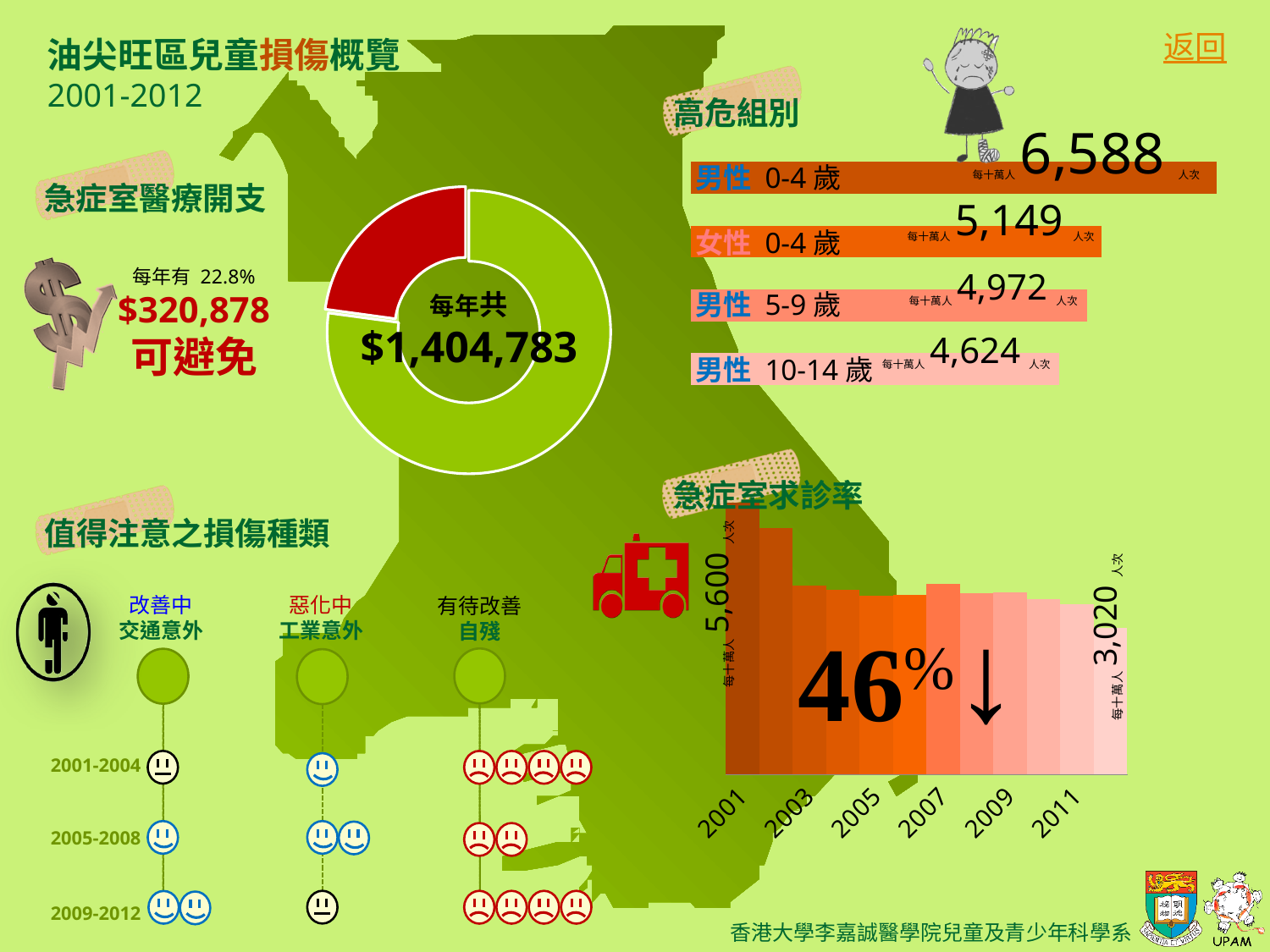
What kind of chart is used for 急症室醫療開支? Donut (pie) chart In the 急症室醫療開支 donut chart, what is the total annual amount (每年共)? $1,404,783 In the 高危組別 bar chart, what is the value for 女性 0-4 歲? 5,149 In the 高危組別 bar chart, what is the difference between 男性 0-4 歲 and 女性 0-4 歲? 1,439 In the 高危組別 bar chart, which group has the lowest value? 男性 10-14 歲 In the 高危組別 bar chart, which group has the highest value? 男性 0-4 歲 In the 高危組別 bar chart, which is larger: 男性 5-9 歲 or 男性 10-14 歲? 男性 5-9 歲 In the 急症室求診率 bar chart, do the values rise or fall from 2001 to 2011? Fall In the 急症室求診率 bar chart, what is the value for 2001 (每十萬人)? 5,600 In the 急症室醫療開支 donut chart, what share of the total is marked as 可避免? 22.8% In the 高危組別 bar chart, what is the value for 男性 0-4 歲? 6,588 In the 高危組別 bar chart, how many groups are shown? 4